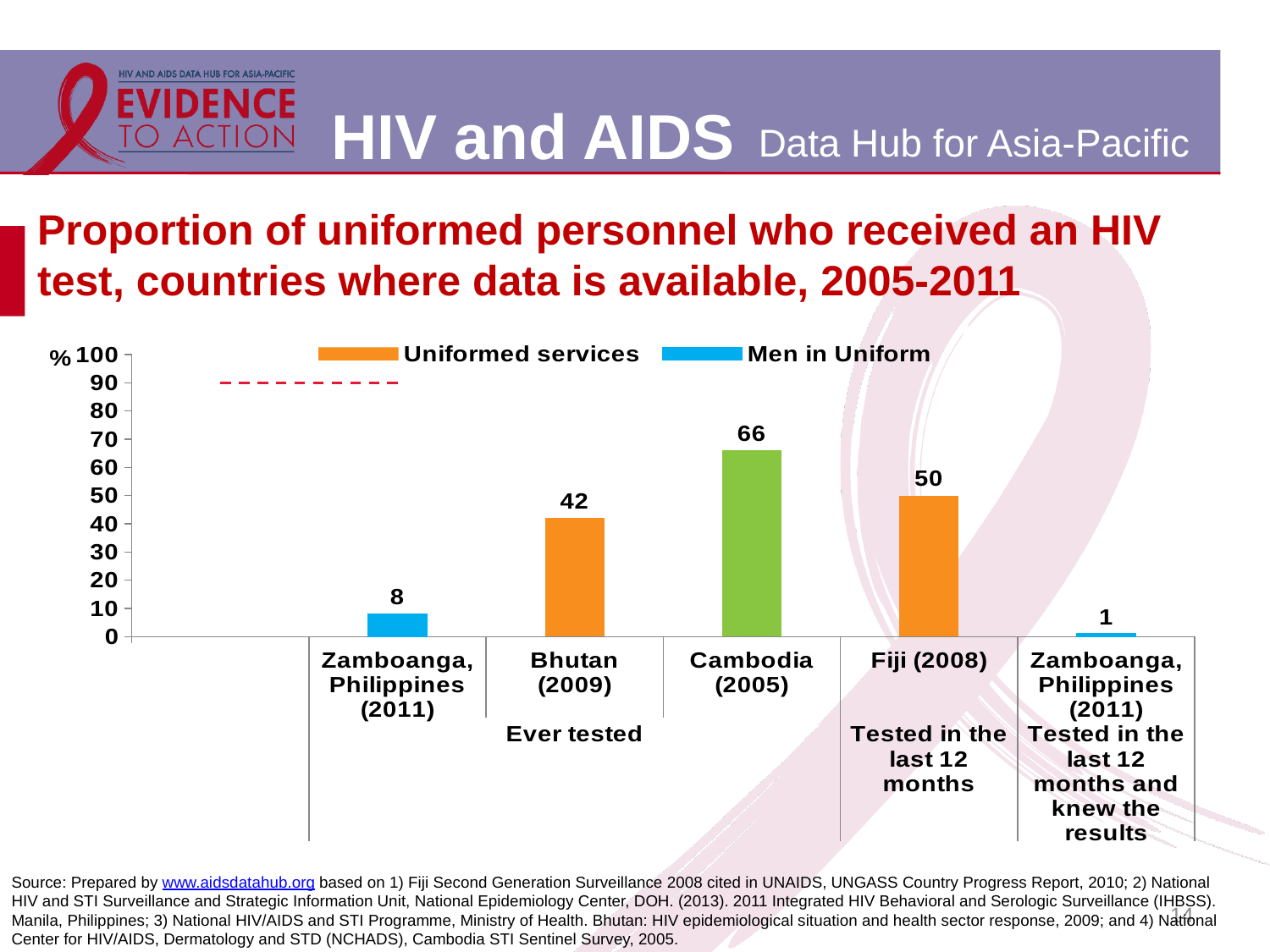
What is the difference between the values for Cambodia (2005) and Bhutan (2009)? 24 Which is larger, the value for Fiji (2008) or the value for Bhutan (2009)? Fiji (2008) What is the value for Zamboanga, Philippines (2011) under Tested in the last 12 months and knew the results? 1 What is the value for Cambodia (2005)? 66 Which bar has the lowest value? Zamboanga, Philippines (2011), Tested in the last 12 months and knew the results How many series does the legend list? 2 What type of chart is shown on the slide? Bar chart What is the value for Zamboanga, Philippines (2011) under Ever tested? 8 Which category has the highest value? Cambodia (2005) What is the value for Bhutan (2009) under Ever tested? 42 How many bars are plotted in the chart? 5 What is the value for Fiji (2008) under Tested in the last 12 months? 50